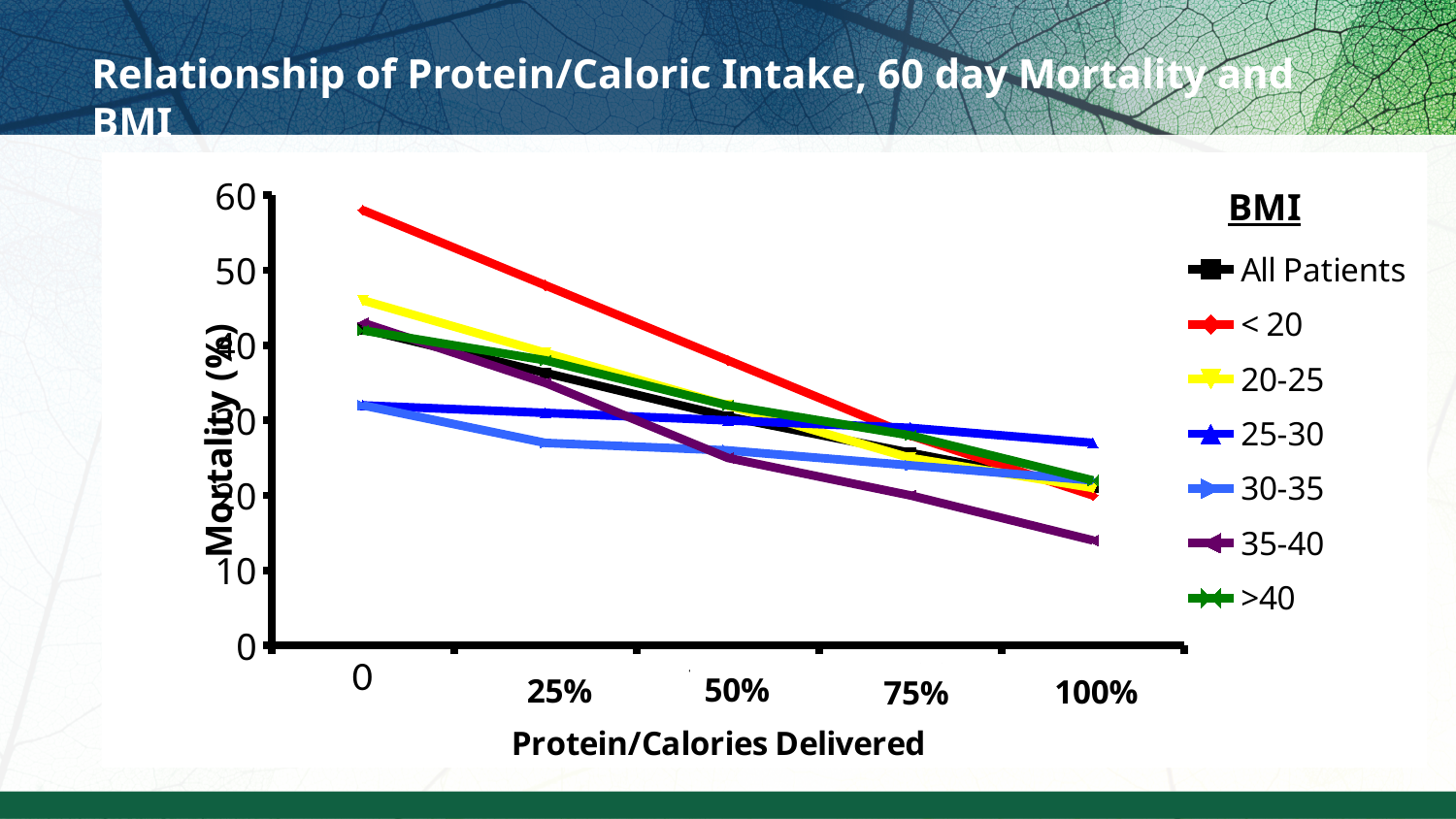
Is the mortality for the 35-40 BMI group at 100% Protein/Calories Delivered greater or less than 20? less Do the mortality values for the < 20 BMI group rise or fall as Protein/Calories Delivered increases? fall What is the title of the legend on the chart? BMI What kind of chart is shown on the slide? line chart How many points are marked along the x axis (Protein/Calories Delivered)? 5 At 100% Protein/Calories Delivered, which has the higher mortality: the 25-30 group or the 35-40 group? 25-30 Is the mortality for the 20-25 BMI group at 0 Protein/Calories Delivered greater or less than 40? greater Which BMI group has the highest mortality at 0 Protein/Calories Delivered? < 20 At 50% Protein/Calories Delivered, which has the higher mortality: the < 20 group or the 30-35 group? < 20 Which BMI group has the lowest mortality at 100% Protein/Calories Delivered? 35-40 Is the mortality for the < 20 BMI group at 0 Protein/Calories Delivered greater or less than 50? greater How many series does the legend list? 7